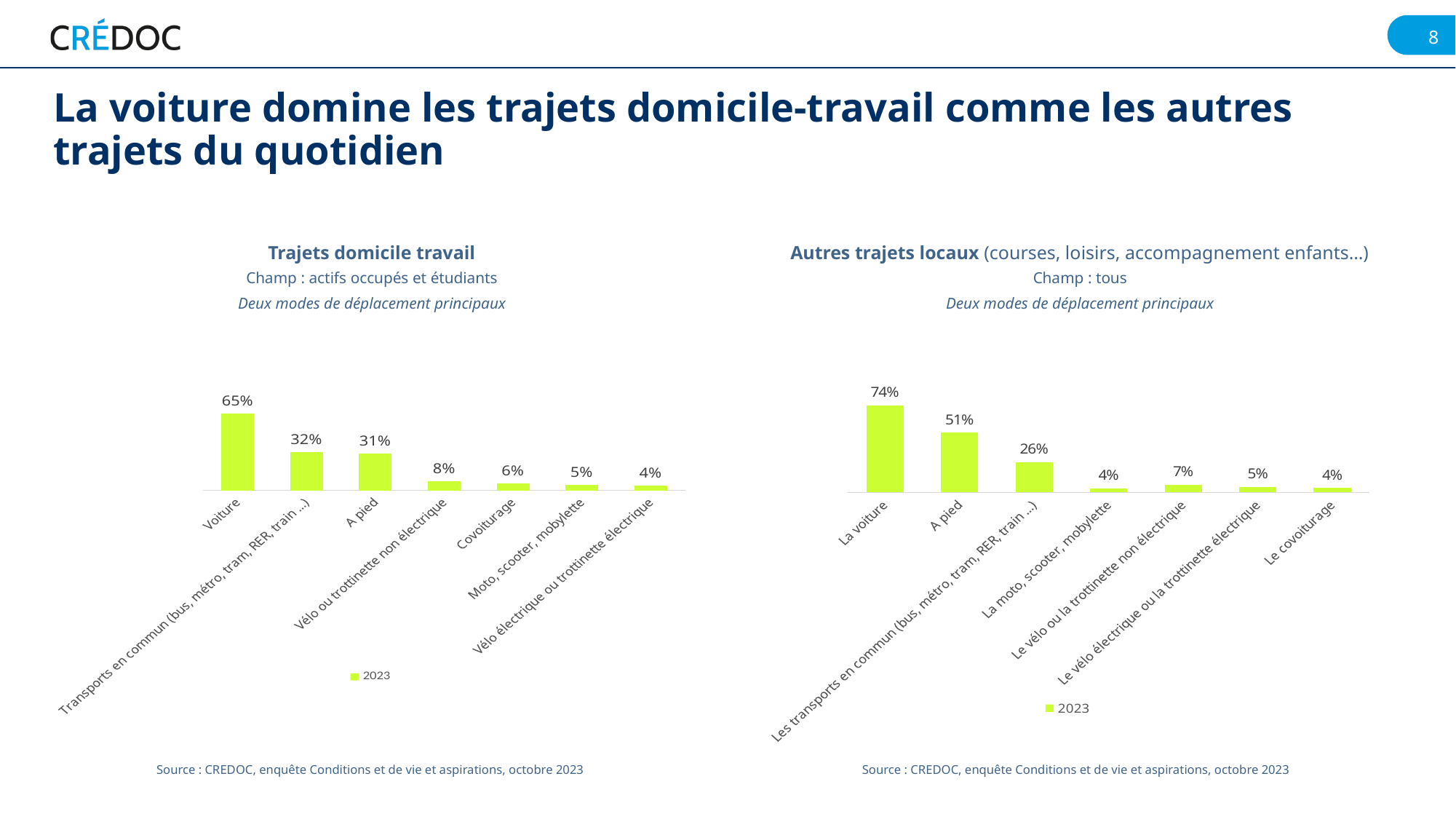
In the 'Trajets domicile travail' chart, which category has the highest value? Voiture In the 'Trajets domicile travail' chart, what is the difference between Voiture and A pied? 34 percentage points In the 'Trajets domicile travail' chart, what is the value for Covoiturage? 6% What kind of chart is the 'Trajets domicile travail' chart? Bar chart In the 'Autres trajets locaux' chart, what is the difference between La voiture and Les transports en commun? 48 percentage points How many categories are shown in the 'Autres trajets locaux' chart? 7 In the 'Autres trajets locaux' chart, what is the value for Le vélo ou la trottinette non électrique? 7% In the 'Autres trajets locaux' chart, which category has the highest value? La voiture In the 'Autres trajets locaux' chart, what is the value for A pied? 51% How many series does the legend of the 'Trajets domicile travail' chart list? 1 In the 'Trajets domicile travail' chart, what is the value for Voiture? 65% In the 'Trajets domicile travail' chart, which is larger: Transports en commun or A pied? Transports en commun